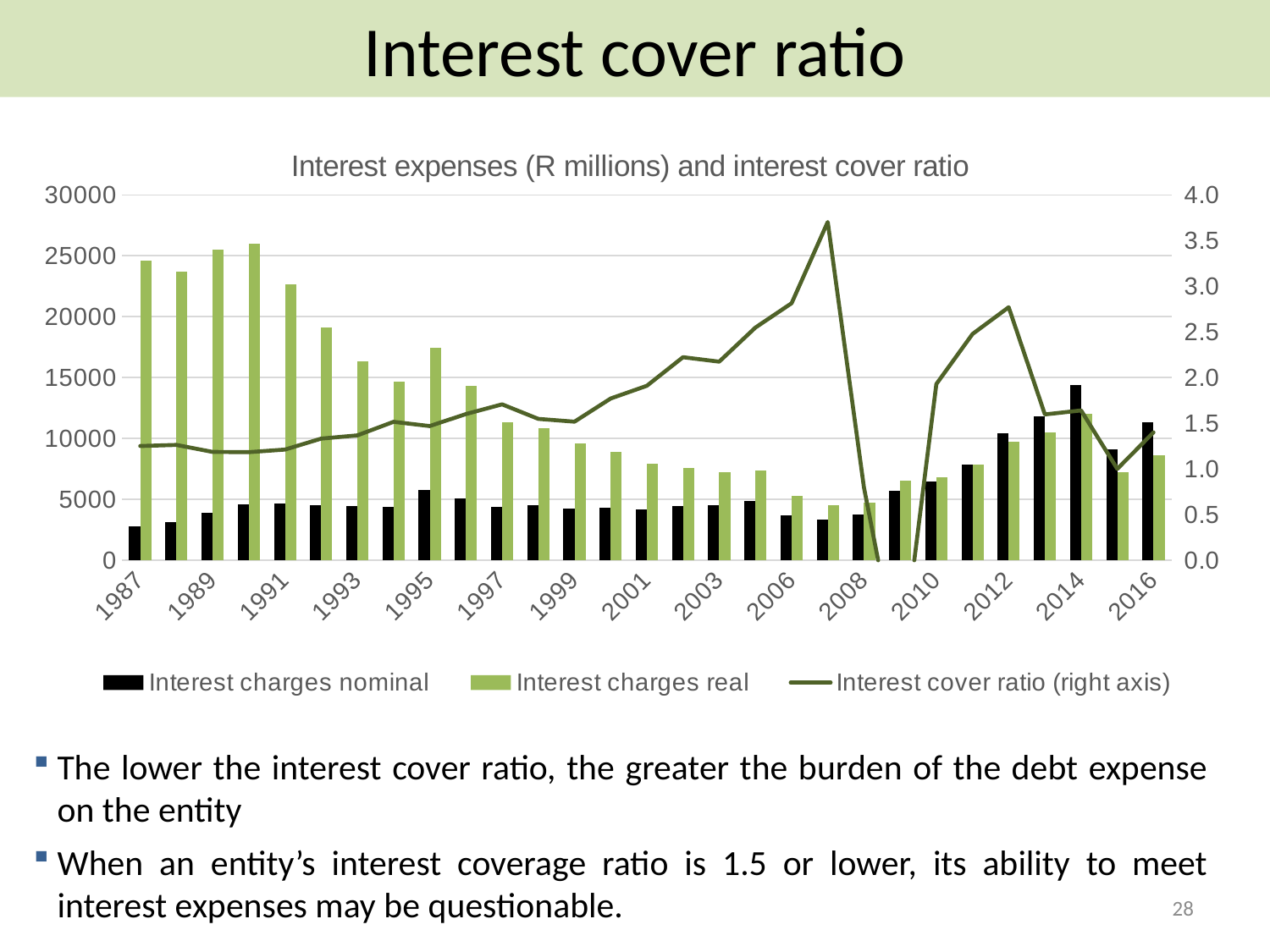
How many series does the chart legend list? 3 Is the peak value of the interest cover ratio greater or less than 3.5? greater Which year has larger real interest charges, 1995 or 1997? 1995 What is the title of the chart? Interest expenses (R millions) and interest cover ratio Is the interest cover ratio in 2012 greater or less than 2.5? greater What kind of chart is shown on the slide? Combined bar and line chart Which series is plotted against the right axis? Interest cover ratio Are the real interest charges in 1987 greater or less than 20000? greater Do the real interest charges generally rise or fall from 1987 to 2008? fall In which year are the nominal interest charges highest? 2014 Which is larger in 2016, the nominal interest charges or the real interest charges? Interest charges nominal